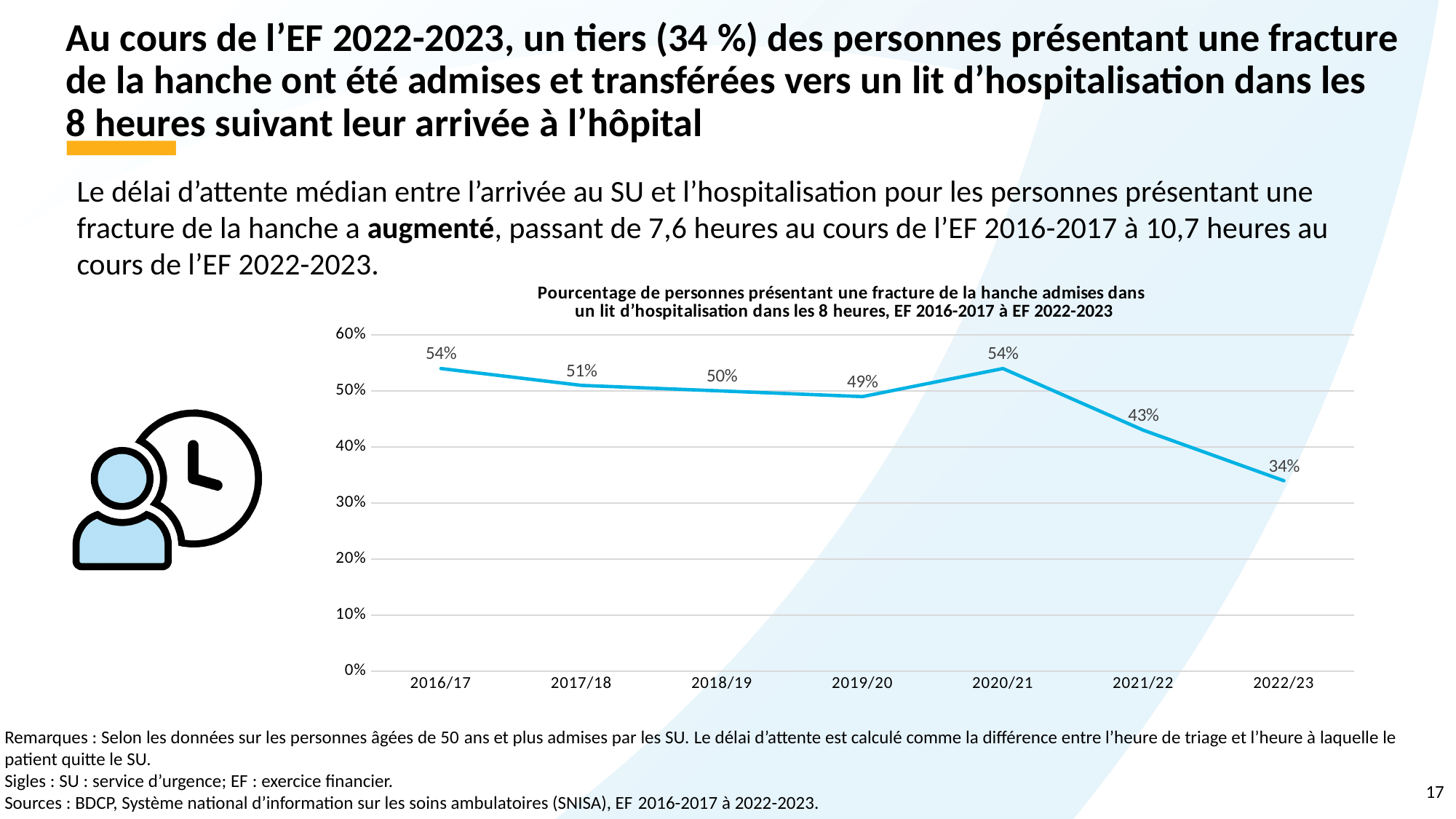
What is the highest value shown on the y axis? 60% What is the value shown for 2019/20? 49% Is the value for 2021/22 greater or less than 40%? greater What kind of chart is shown on the slide? Line chart What is the value shown for 2020/21? 54% Which fiscal year has the lowest value on the chart? 2022/23 What percentage of people with a hip fracture were admitted to an inpatient bed within 8 hours in 2022/23? 34% How many fiscal years are plotted on the x axis? 7 Does the value rise or fall between 2020/21 and 2022/23? Fall Which is larger, the value for 2021/22 or the value for 2019/20? 2019/20 What is the difference between the values for 2016/17 and 2017/18? 3 percentage points What is the difference between the values for 2020/21 and 2022/23? 20 percentage points